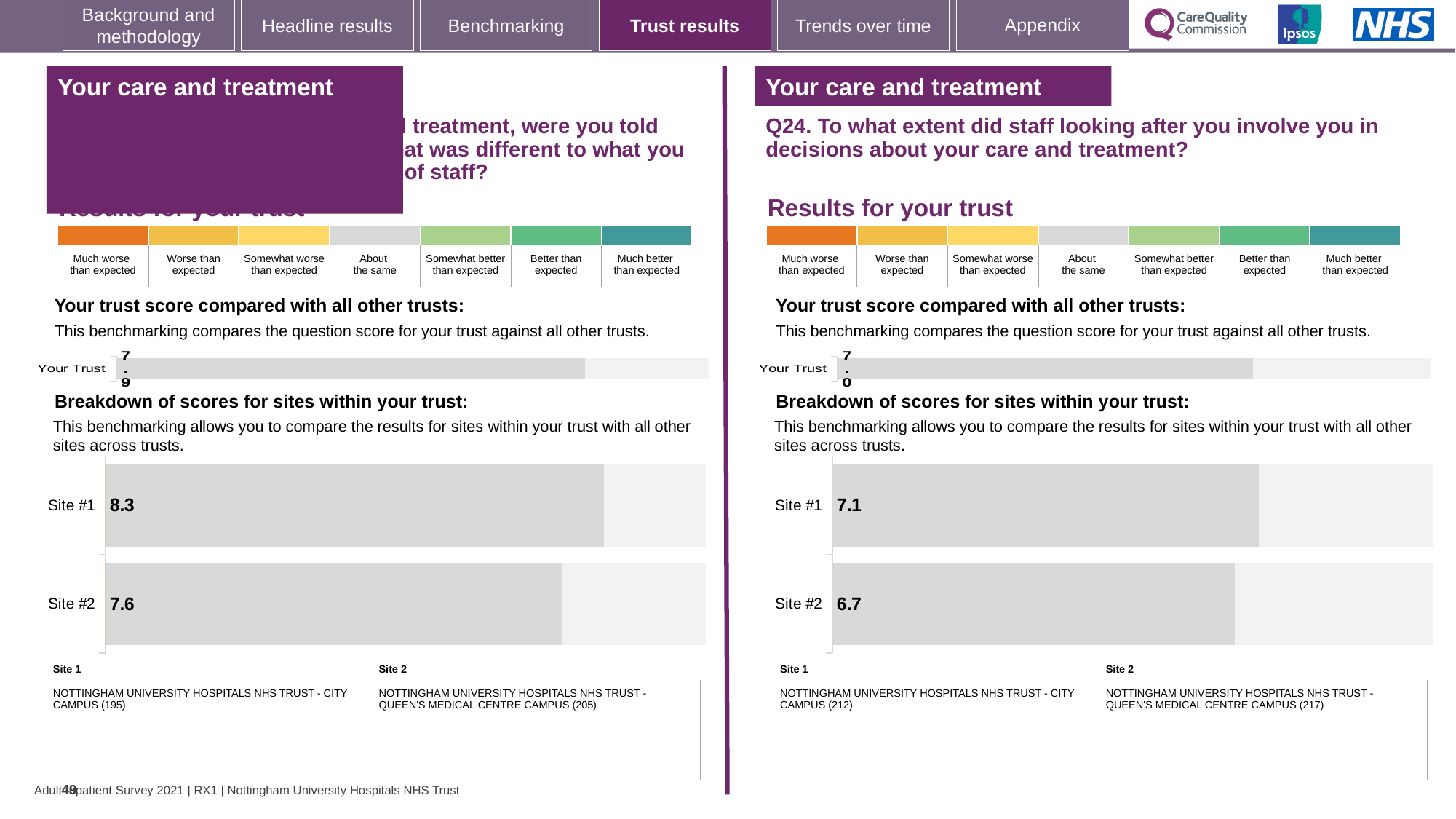
On the left-hand chart, what is the score shown for Your Trust? 7.9 On the left-hand site breakdown chart, what is the difference between the Site #1 and Site #2 scores? 0.7 On the right-hand chart (Q24), what is the score for Site #1? 7.1 On the right-hand chart (Q24), what is the difference between the Site #1 and Site #2 scores? 0.4 On the left-hand site breakdown chart, what is the score for Site #2? 7.6 On the right-hand chart (Q24), which site has the higher score? Site #1 What type of chart is used for the site breakdown on the right-hand side (Q24)? Bar chart On the right-hand chart (Q24), what is the score for Site #2? 6.7 How many sites are shown in the site breakdown chart on the right-hand side (Q24)? 2 On the left-hand site breakdown chart, what is the score for Site #1? 8.3 On the right-hand chart (Q24), what is the score shown for Your Trust? 7.0 On the left-hand site breakdown chart, which site has the lower score? Site #2